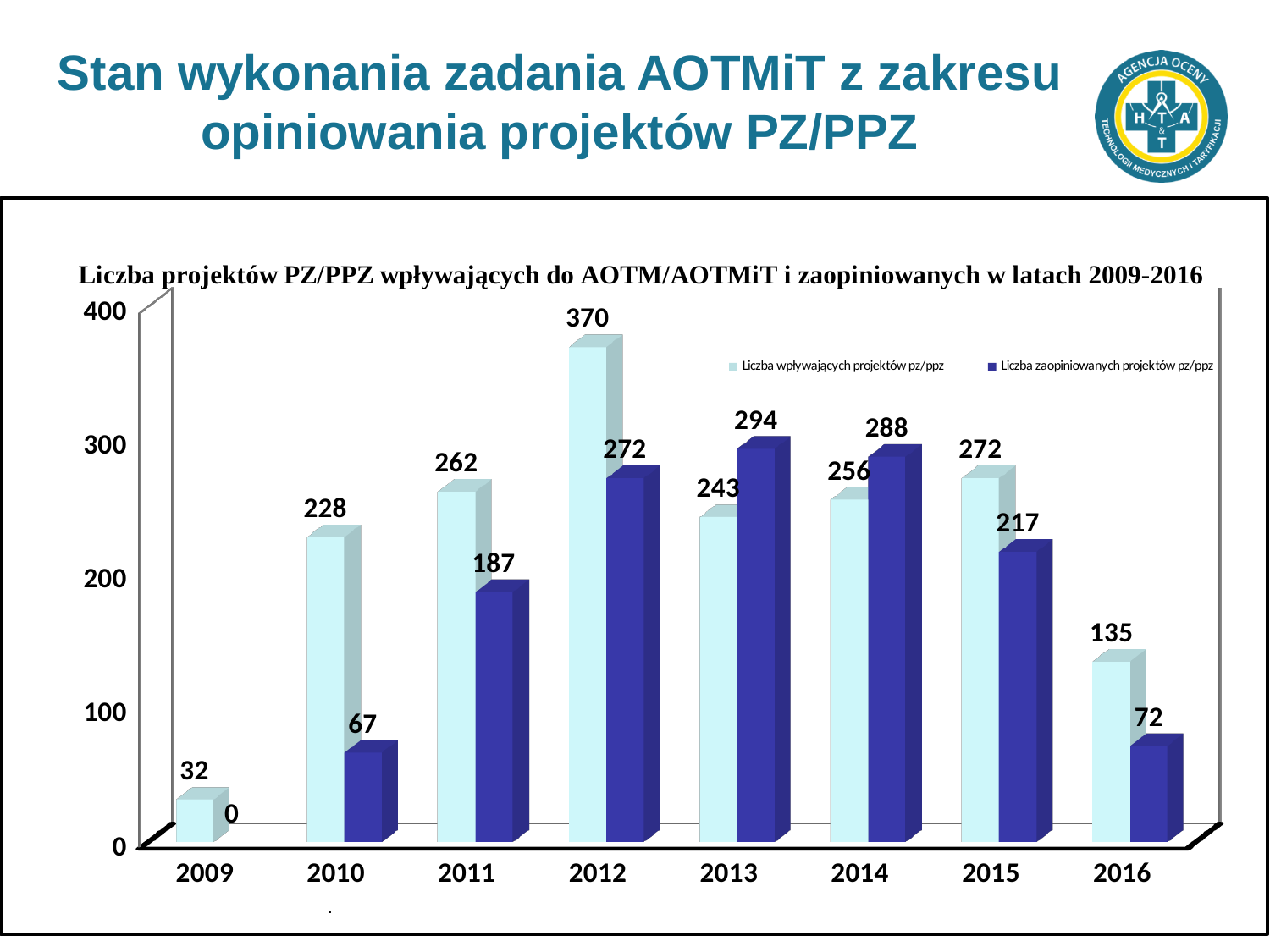
In which year is 'Liczba wpływających projektów pz/ppz' highest? 2012 What is the difference between 'Liczba wpływających projektów pz/ppz' and 'Liczba zaopiniowanych projektów pz/ppz' in 2010? 161 In 2014, which is larger: 'Liczba wpływających projektów pz/ppz' or 'Liczba zaopiniowanych projektów pz/ppz'? Liczba zaopiniowanych projektów pz/ppz How many series does the legend list? 2 What is the value of 'Liczba zaopiniowanych projektów pz/ppz' for 2011? 187 In which year is 'Liczba zaopiniowanych projektów pz/ppz' highest? 2013 What type of chart is shown on the slide? bar chart What is the title of the chart? Liczba projektów PZ/PPZ wpływających do AOTM/AOTMiT i zaopiniowanych w latach 2009-2016 In which year is 'Liczba wpływających projektów pz/ppz' lowest? 2009 What is the value of 'Liczba zaopiniowanych projektów pz/ppz' for 2009? 0 What is the value of 'Liczba wpływających projektów pz/ppz' for 2012? 370 How many years are shown on the x axis? 8